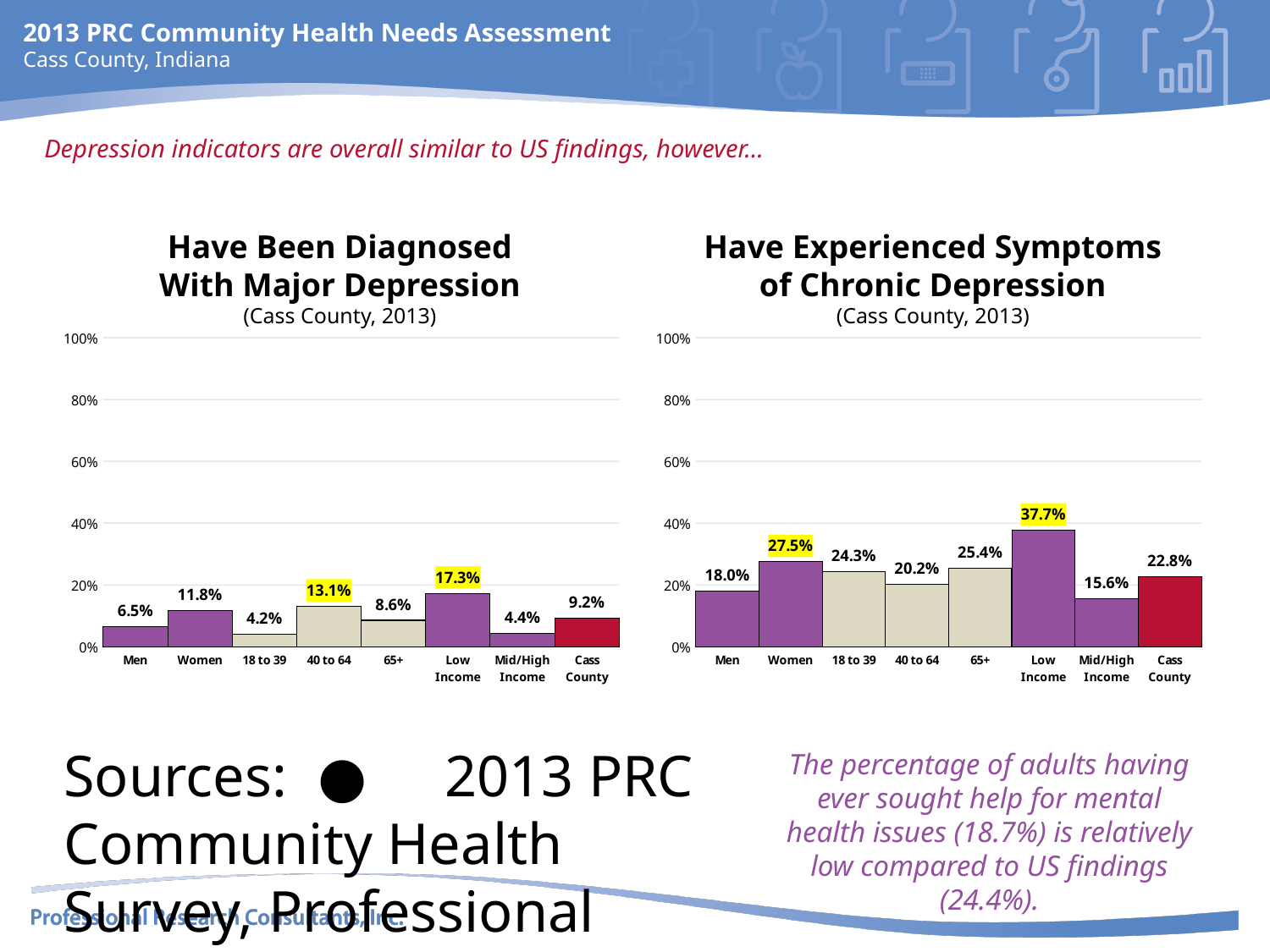
In the 'Have Experienced Symptoms of Chronic Depression' chart, which category has the lowest value? Mid/High Income In the 'Have Experienced Symptoms of Chronic Depression' chart, is the value for Low Income greater or less than 40%? less In the 'Have Been Diagnosed With Major Depression' chart, what is the value for Women? 11.8% In the 'Have Been Diagnosed With Major Depression' chart, how many categories are shown? 8 In the 'Have Been Diagnosed With Major Depression' chart, which category has the lowest value? 18 to 39 In the 'Have Experienced Symptoms of Chronic Depression' chart, which category has the highest value? Low Income In the 'Have Been Diagnosed With Major Depression' chart, what is the difference between the Low Income and Mid/High Income values? 12.9% What kind of chart is the 'Have Been Diagnosed With Major Depression' chart? Bar chart In the 'Have Experienced Symptoms of Chronic Depression' chart, what is the value for Cass County? 22.8% In the 'Have Experienced Symptoms of Chronic Depression' chart, which is larger, the value for Men or the value for Women? Women In the 'Have Experienced Symptoms of Chronic Depression' chart, what is the difference between the Women and Men values? 9.5% In the 'Have Been Diagnosed With Major Depression' chart, which category has the highest value? Low Income